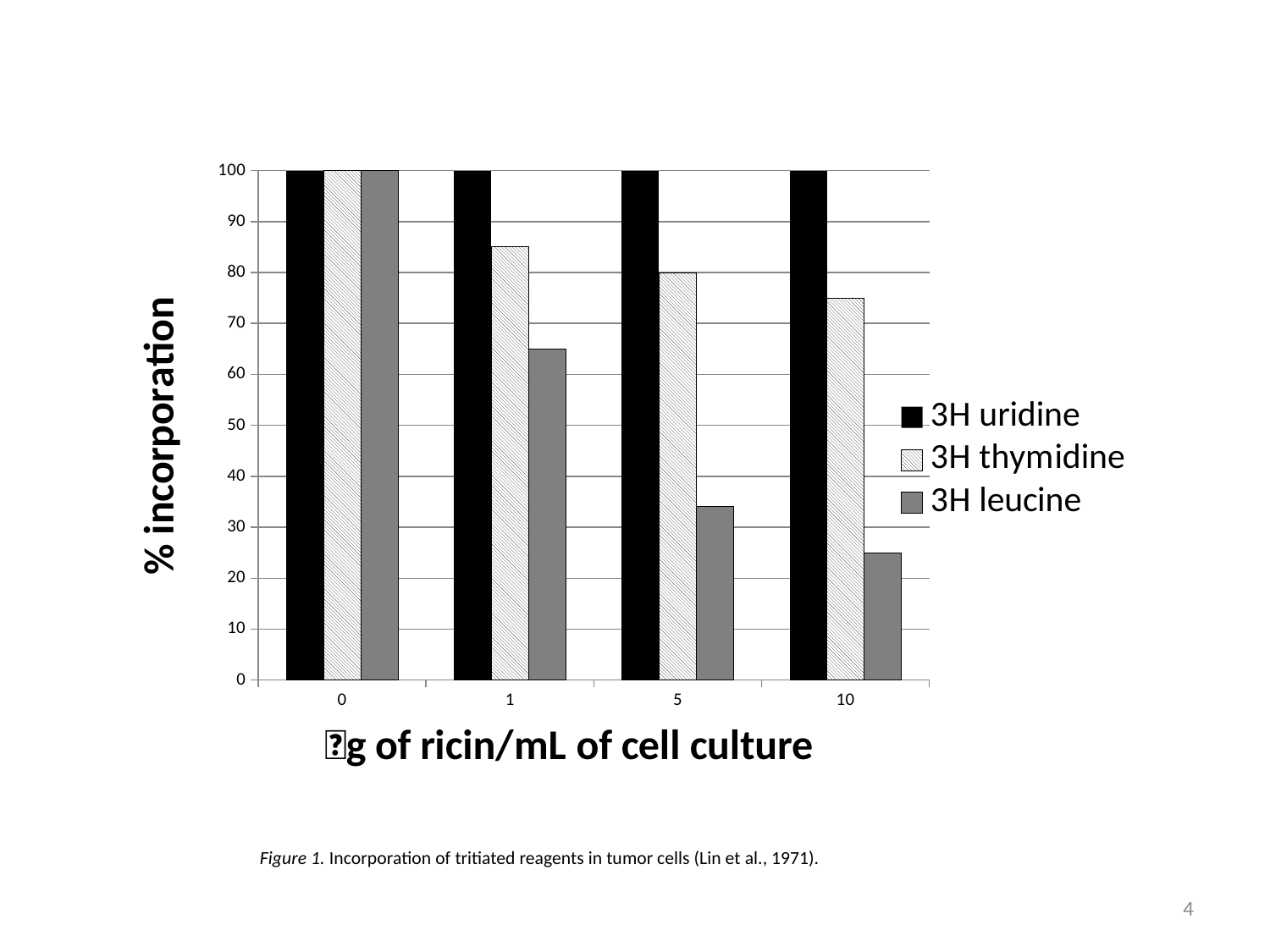
What is the % incorporation for 3H uridine at 10 µg of ricin/mL? 100 What kind of chart is shown on the slide? bar chart Is the value for 3H leucine at 5 µg of ricin/mL greater or less than 40? less Which series has the lowest value at 10 µg of ricin/mL? 3H leucine How many ricin concentration categories are shown on the x axis? 4 What is the % incorporation for 3H thymidine at 0 µg of ricin/mL? 100 Is the value for 3H thymidine at 1 µg of ricin/mL greater or less than 80? greater Do the 3H leucine values rise or fall as the ricin concentration increases along the x axis? fall What is the % incorporation for 3H thymidine at 5 µg of ricin/mL? 80 At 5 µg of ricin/mL, which is larger: 3H thymidine or 3H leucine? 3H thymidine How many series does the legend list? 3 Is the value for 3H leucine at 10 µg of ricin/mL greater or less than 30? less